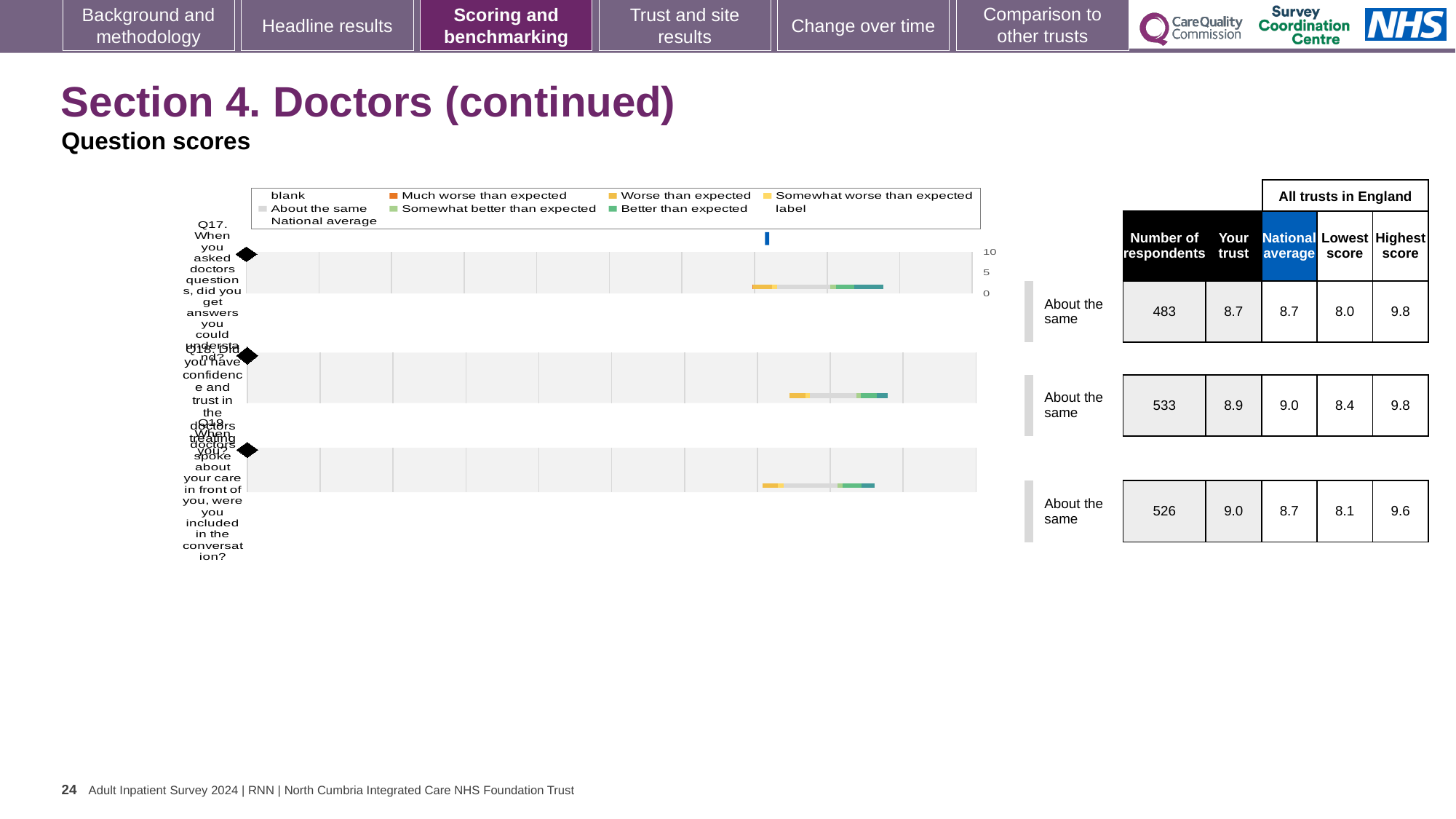
What kind of chart is shown on the slide? bar chart In the chart legend, what colour represents 'Much worse than expected'? orange For Q19, which is larger: the 'Your trust' score or the national average? Your trust In the table beside the chart, what is the national average for Q19? 8.7 Which question has the highest 'Your trust' score? Q19 In the table beside the chart, what is the 'Your trust' score for Q17? 8.7 In the table beside the chart, what is the highest score for Q19? 9.6 Which question has the lowest number of respondents? Q17 What is the highest tick value shown on the chart's score axis? 10 How many questions (categories) are plotted in the chart? 3 For Q18, what is the difference between the highest score and the lowest score? 1.4 In the table beside the chart, what is the number of respondents for Q18? 533